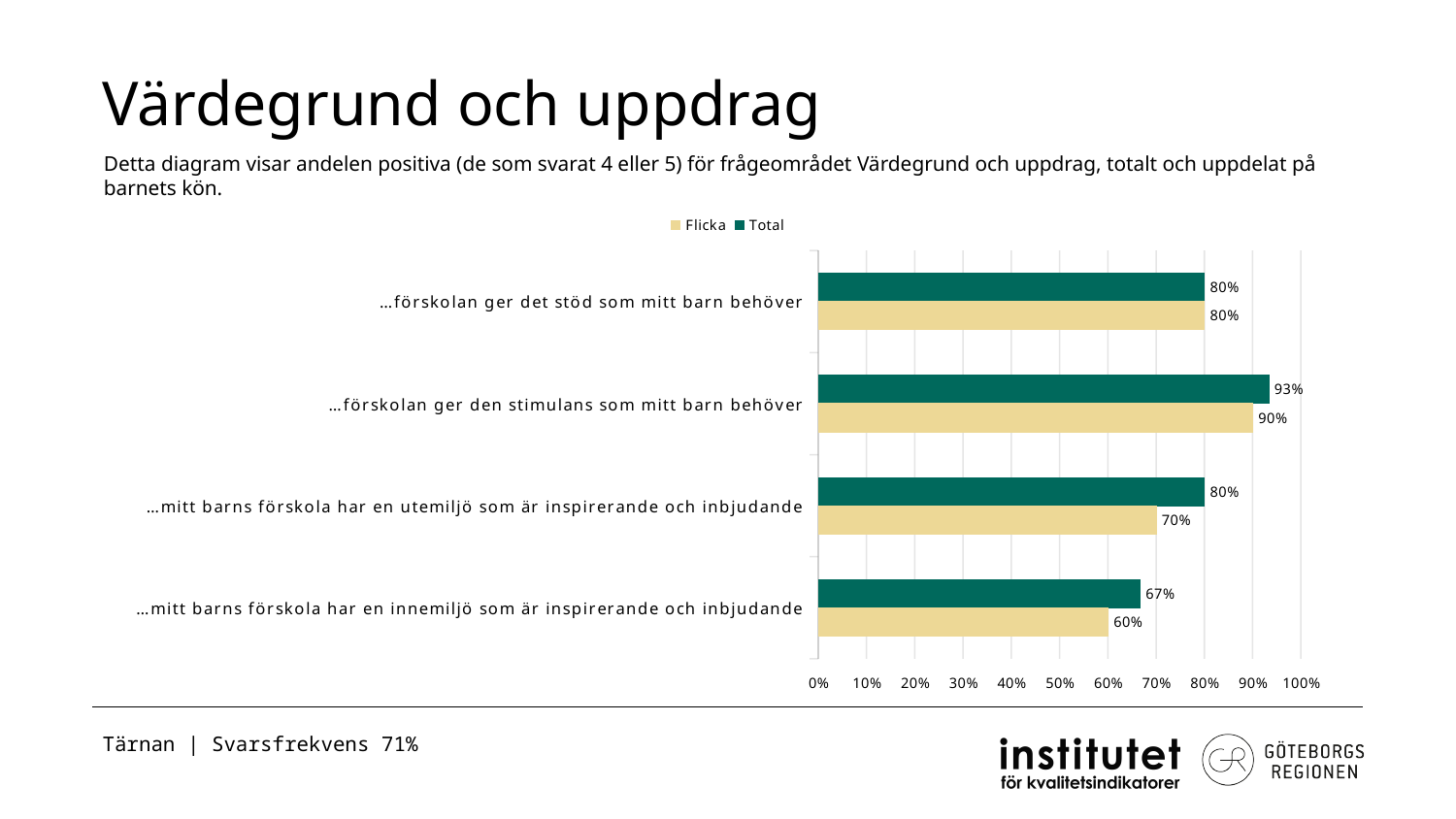
What is the Flicka value for "…mitt barns förskola har en utemiljö som är inspirerande och inbjudande"? 70% How many series does the legend list? 2 What kind of chart is shown on the slide? Bar chart Which category has the lowest Flicka value? …mitt barns förskola har en innemiljö som är inspirerande och inbjudande Which category has the highest Total value? …förskolan ger den stimulans som mitt barn behöver Which is larger for "…mitt barns förskola har en innemiljö som är inspirerande och inbjudande": the Total value or the Flicka value? Total What is the difference between the Total and Flicka values for "…mitt barns förskola har en utemiljö som är inspirerande och inbjudande"? 10% What is the Total value for "…förskolan ger den stimulans som mitt barn behöver"? 93% Is the Total value for "…mitt barns förskola har en innemiljö som är inspirerande och inbjudande" greater or less than 70%? less How many categories (statements) are shown in the chart? 4 Which series is shown in green in the chart? Total What is the Flicka value for "…mitt barns förskola har en innemiljö som är inspirerande och inbjudande"? 60%